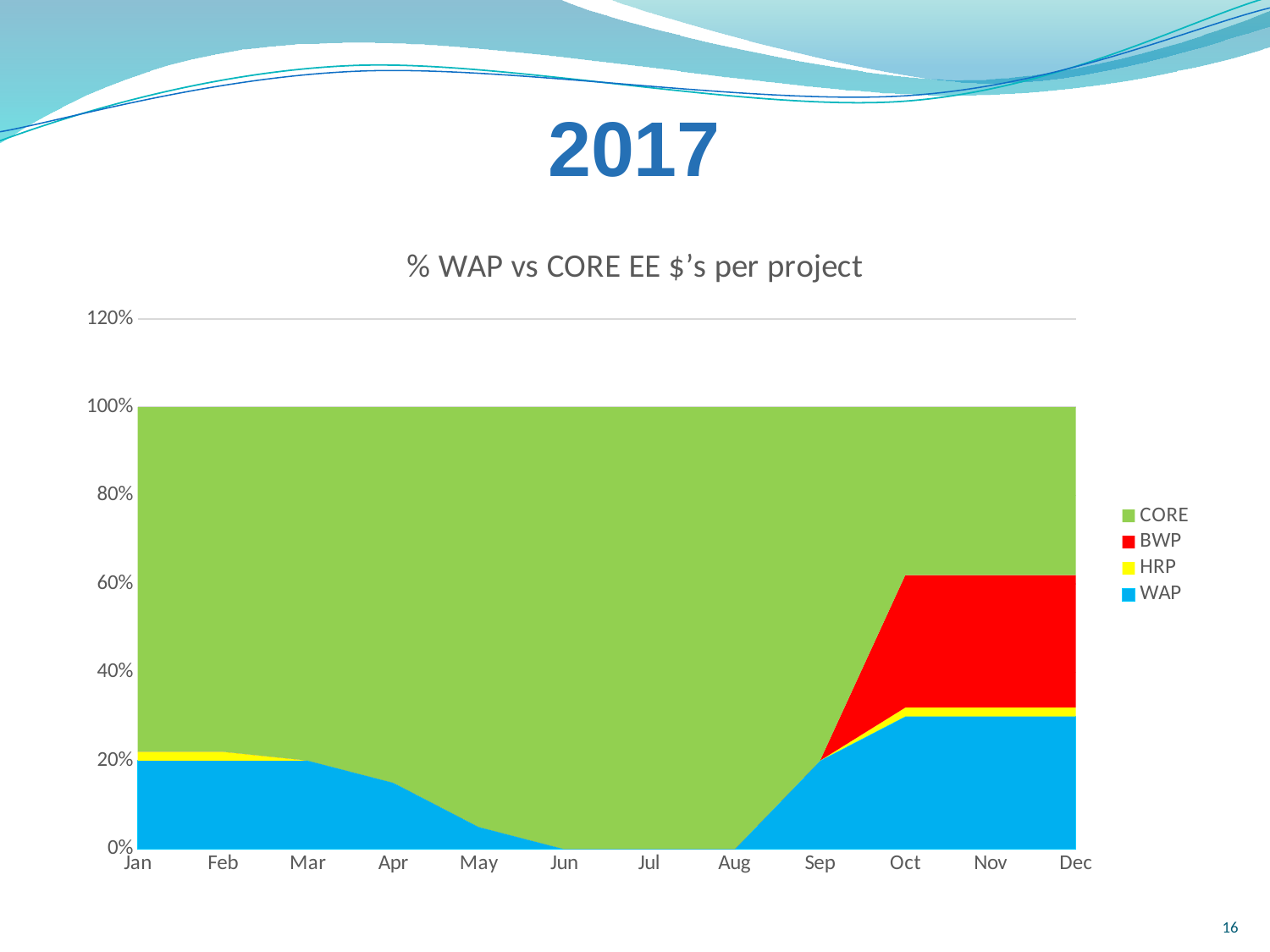
Which series occupies the largest share in Jan? CORE Is the value for WAP in Jan greater or less than 40%? less Does the WAP share rise or fall from Jan to Jul? fall Which series is shown in green in the legend? CORE What is the title of the chart? % WAP vs CORE EE $'s per project What kind of chart is shown on the slide? Area chart How many series does the legend list? 4 Is the value for WAP in Dec greater or less than 20%? greater How many months are shown along the x axis? 12 Is the value for WAP in Apr greater or less than 20%? less